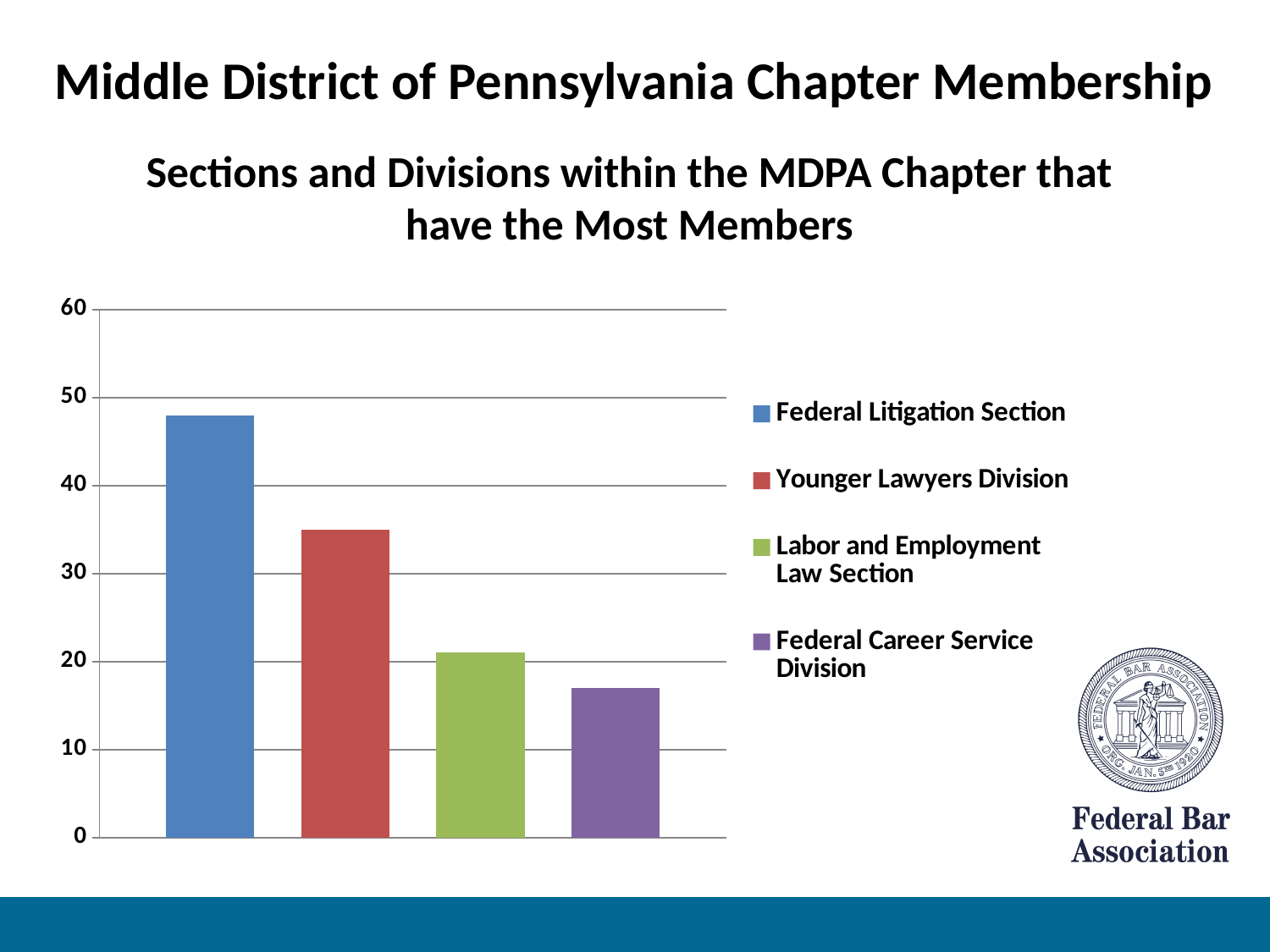
Is the value for the Labor and Employment Law Section greater or less than 30? less How many entries does the legend list? 4 How many bars are plotted in the chart? 4 Which section or division has the most members? Federal Litigation Section Which has more members, the Younger Lawyers Division or the Labor and Employment Law Section? Younger Lawyers Division What kind of chart is shown on the slide? bar chart Do the bar values rise or fall from left to right across the chart? fall Is the value for the Federal Litigation Section greater or less than 40? greater Is the value for the Younger Lawyers Division greater or less than 30? greater Which section or division has the fewest members? Federal Career Service Division